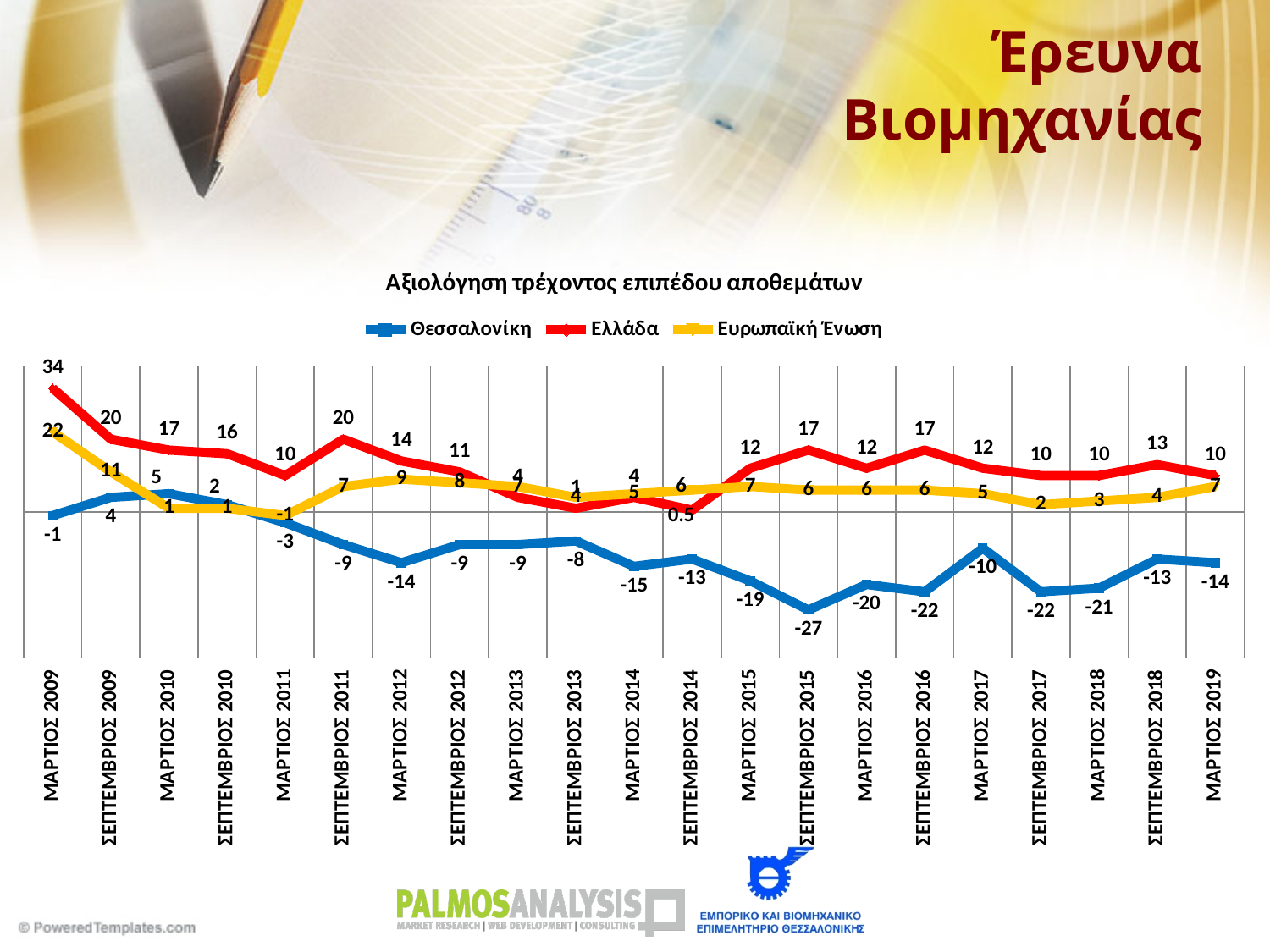
How many series does the legend list? 3 What is the value for Ευρωπαϊκή Ένωση in ΣΕΠΤΕΜΒΡΙΟΣ 2014? 6 In ΜΑΡΤΙΟΣ 2012, which is larger: the value for Ελλάδα or for Ευρωπαϊκή Ένωση? Ελλάδα What is the value for Θεσσαλονίκη in ΣΕΠΤΕΜΒΡΙΟΣ 2015? -27 What is the value for Ελλάδα in ΜΑΡΤΙΟΣ 2009? 34 By how much did the Ελλάδα value fall from ΜΑΡΤΙΟΣ 2009 to ΣΕΠΤΕΜΒΡΙΟΣ 2009? 14 What kind of chart is shown on the slide? line chart How many time points are plotted along the x axis? 21 At which time point does Θεσσαλονίκη reach its lowest value? ΣΕΠΤΕΜΒΡΙΟΣ 2015 What is the title of the chart? Αξιολόγηση τρέχοντος επιπέδου αποθεμάτων At which time point does Ελλάδα reach its highest value? ΜΑΡΤΙΟΣ 2009 What is the difference between the Ελλάδα and Θεσσαλονίκη values in ΜΑΡΤΙΟΣ 2019? 24